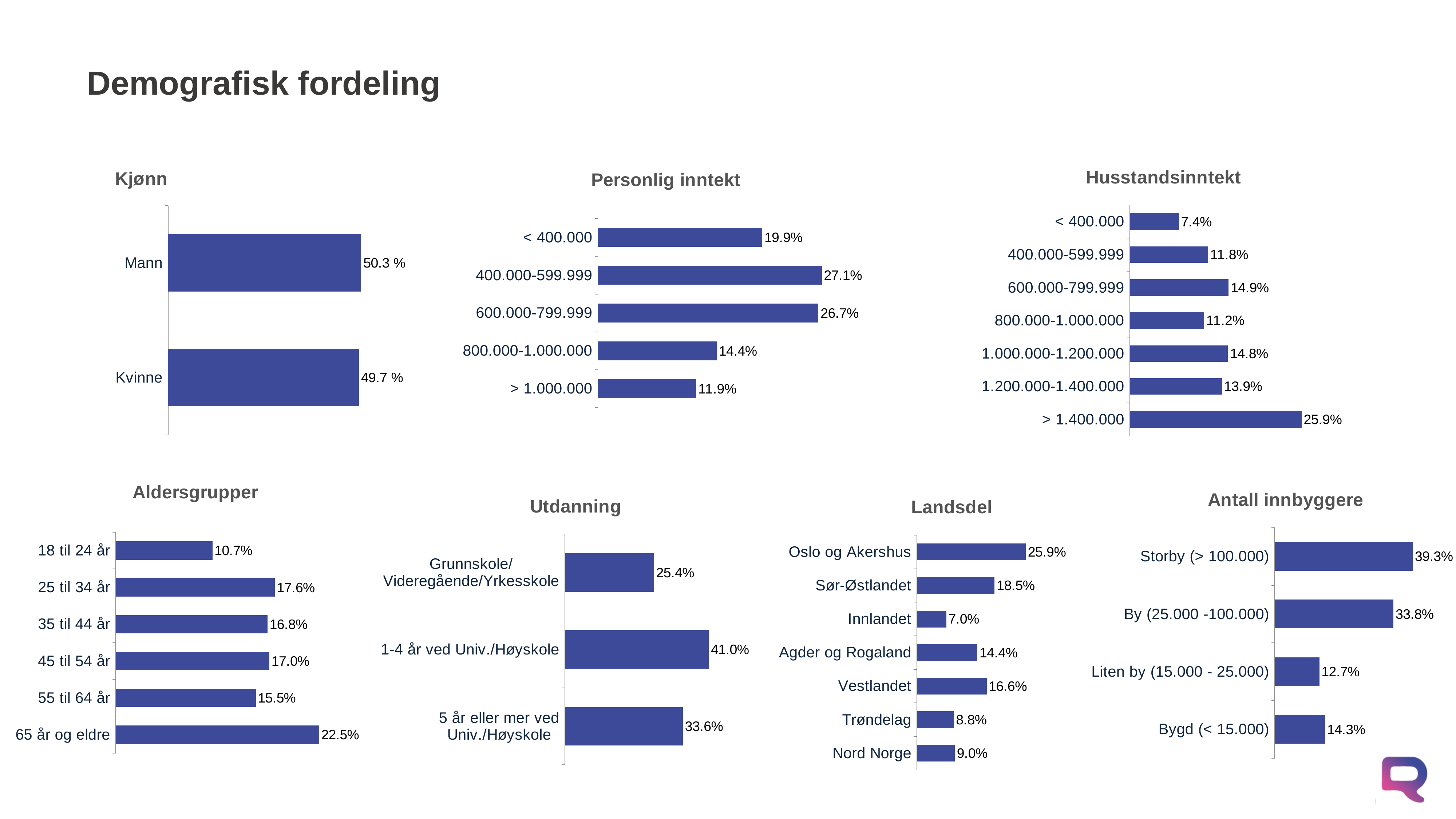
In the Husstandsinntekt chart, what is the value for > 1.400.000? 25.9% What kind of chart is the Personlig inntekt chart? Bar chart In the Personlig inntekt chart, which income category has the highest value? 400.000-599.999 In the Aldersgrupper chart, what is the difference between the values for 65 år og eldre and 18 til 24 år? 11.8% In the Utdanning chart, which category has the highest value? 1-4 år ved Univ./Høyskole In the Antall innbyggere chart, what is the difference between the values for Storby (> 100.000) and By (25.000 -100.000)? 5.5% In the Landsdel chart, how many regions are shown? 7 How many charts are shown on the slide? 7 In the Landsdel chart, which is larger, the value for Vestlandet or the value for Agder og Rogaland? Vestlandet In the Antall innbyggere chart, what is the value for Liten by (15.000 - 25.000)? 12.7% In the Kjønn chart, what is the value for Mann? 50.3 % In the Husstandsinntekt chart, which category has the lowest value? < 400.000